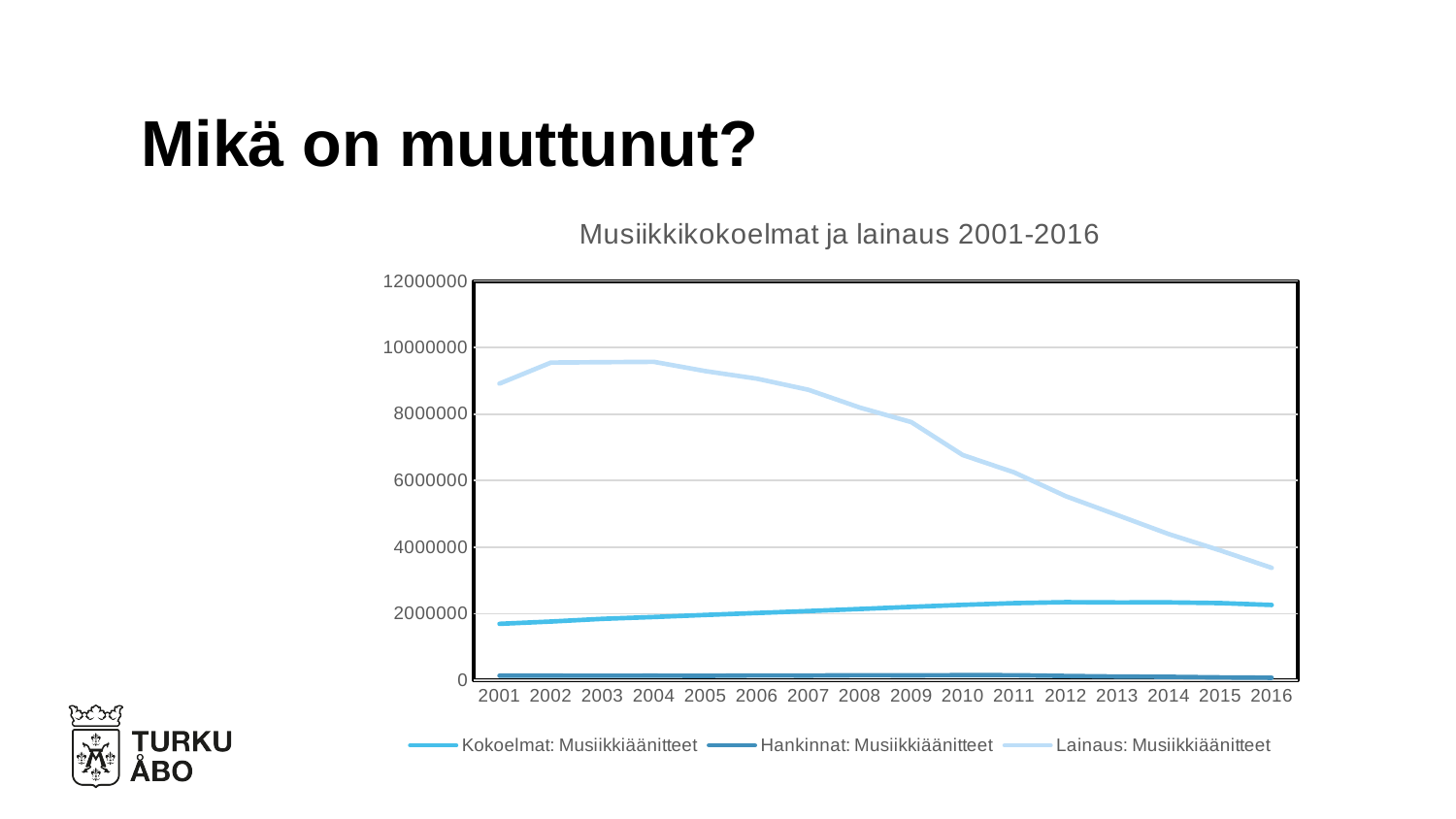
What is the title of the chart? Musiikkikokoelmat ja lainaus 2001-2016 Which series is drawn with the lightest blue line? Lainaus: Musiikkiäänitteet How many years are shown on the x axis? 16 In which year is the Kokoelmat: Musiikkiäänitteet value lowest? 2001 In 2016, which is larger: Lainaus: Musiikkiäänitteet or Kokoelmat: Musiikkiäänitteet? Lainaus: Musiikkiäänitteet Does the Lainaus: Musiikkiäänitteet series rise or fall from 2004 to 2016? fall How many series does the legend list? 3 In which year is the Lainaus: Musiikkiäänitteet value lowest? 2016 What kind of chart is shown on the slide? line chart Is the value for Lainaus: Musiikkiäänitteet in 2016 greater or less than 4000000? less Is the value for Lainaus: Musiikkiäänitteet in 2001 greater or less than 8000000? greater Is the value for Kokoelmat: Musiikkiäänitteet in 2001 greater or less than 2000000? less